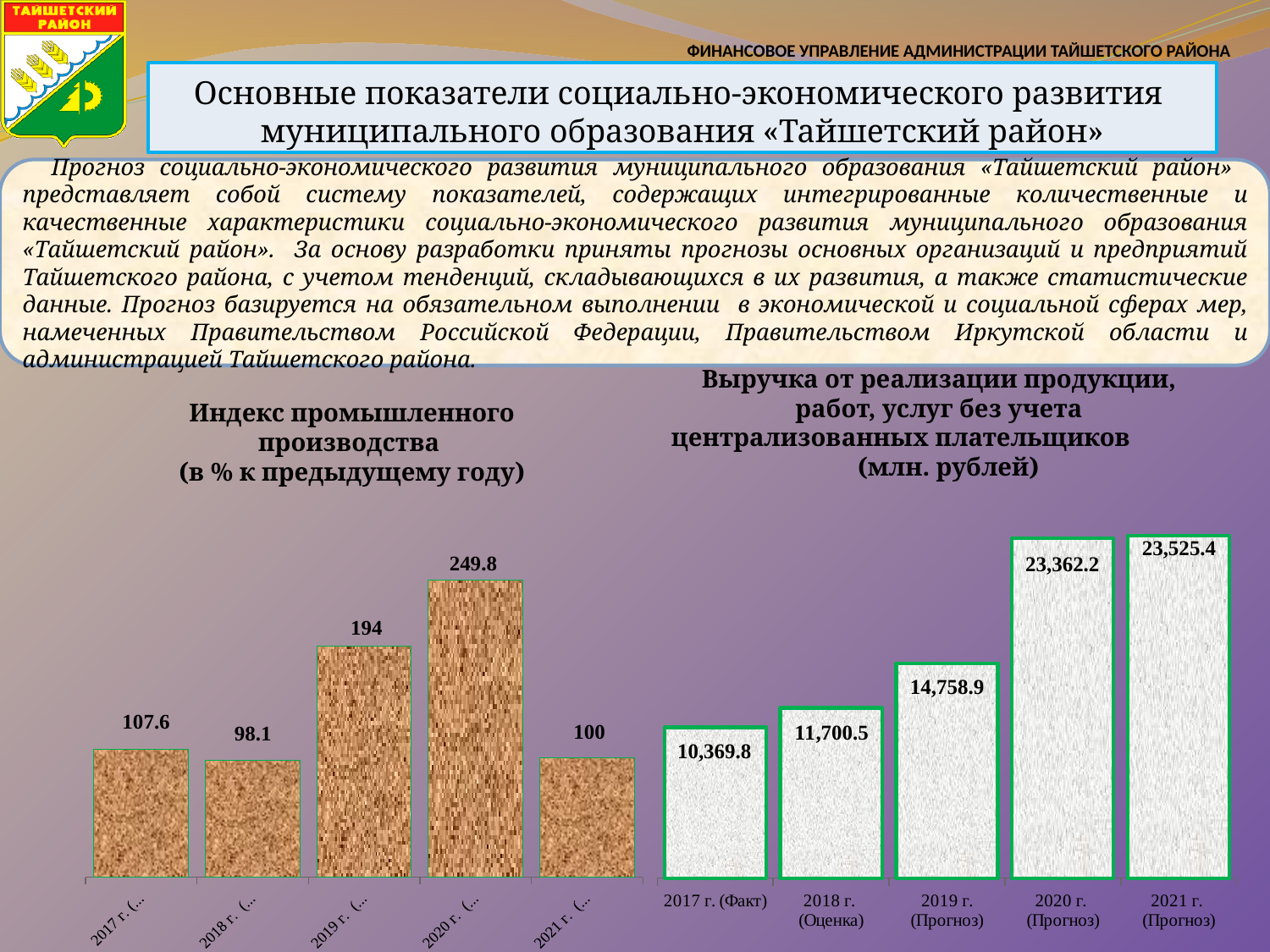
On the left chart (Индекс промышленного производства), which year has the highest value? 2020 г. On the right chart (Выручка от реализации продукции), which year has the highest value? 2021 г. (Прогноз) On the left chart (Индекс промышленного производства), how many bars are plotted? 5 On the right chart (Выручка от реализации продукции), what is the value for 2019 г. (Прогноз)? 14,758.9 On the right chart (Выручка от реализации продукции), what is the value for 2017 г. (Факт)? 10,369.8 On the left chart (Индекс промышленного производства), which year has the lowest value? 2018 г. What kind of chart is the right chart (Выручка от реализации продукции)? bar chart On the right chart (Выручка от реализации продукции), do the values rise or fall from 2017 to 2021? rise On the left chart (Индекс промышленного производства), what is the value for 2019 г.? 194 On the left chart (Индекс промышленного производства), what is the difference between the values for 2020 г. and 2019 г.? 55.8 On the right chart (Выручка от реализации продукции), what is the difference between the values for 2018 г. (Оценка) and 2017 г. (Факт)? 1,330.7 On the left chart (Индекс промышленного производства), what is the value for 2021 г.? 100